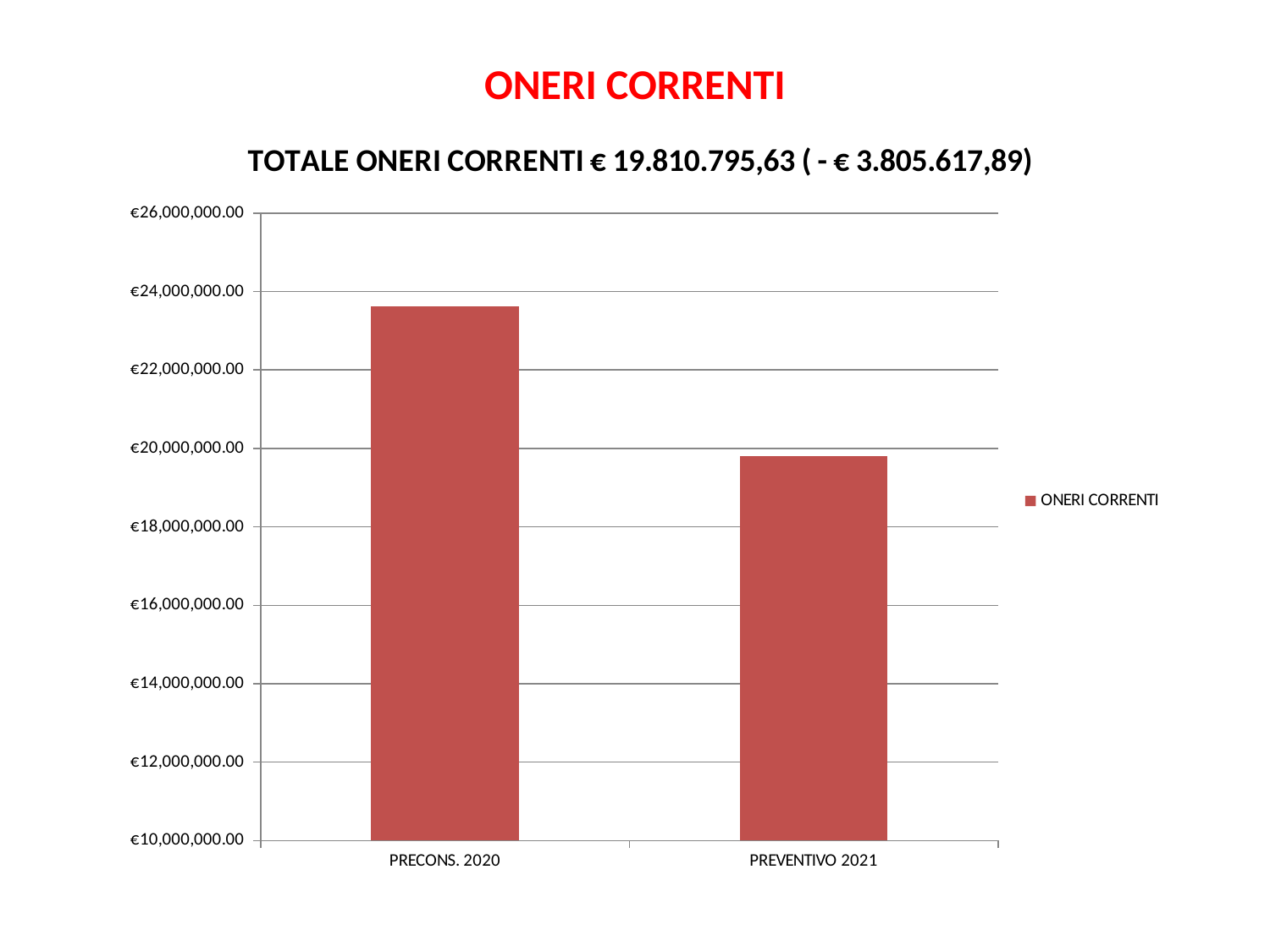
Which category has the highest value in the chart? PRECONS. 2020 What kind of chart is shown on the slide? bar chart How many series does the chart legend list? 1 Which is larger, the value for PRECONS. 2020 or the value for PREVENTIVO 2021? PRECONS. 2020 Which category has the lowest value in the chart? PREVENTIVO 2021 Is the value for PREVENTIVO 2021 greater or less than €18,000,000.00? greater How many categories are shown on the x axis of the chart? 2 Do the values rise or fall from PRECONS. 2020 to PREVENTIVO 2021? fall Is the value for PREVENTIVO 2021 greater or less than €20,000,000.00? less What is the name of the series listed in the chart legend? ONERI CORRENTI Is the value for PRECONS. 2020 greater or less than €22,000,000.00? greater